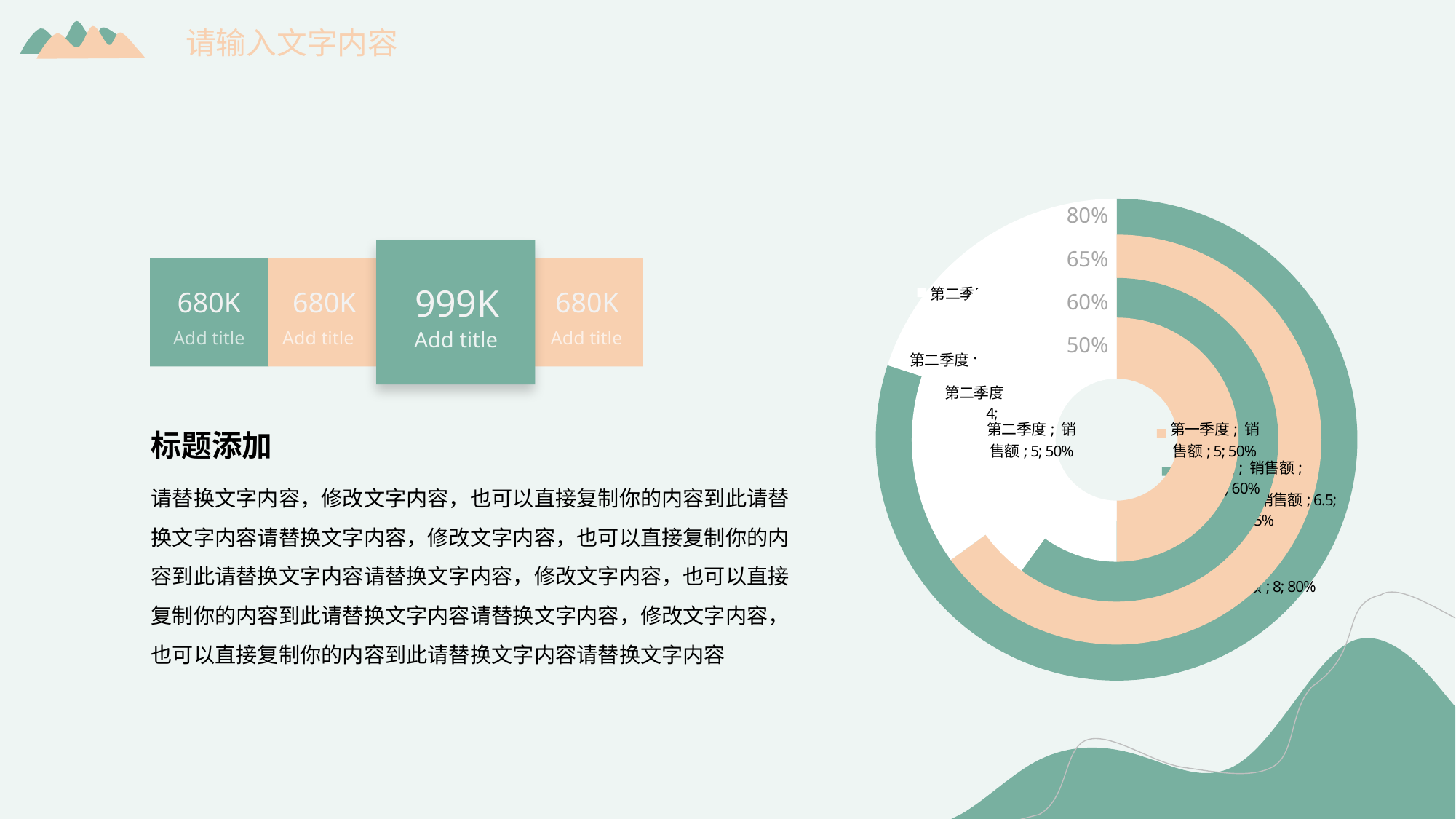
What percentage is printed in the data label for 第二季度 销售额 on the doughnut chart? 50% What value is printed in the data label for 第一季度 销售额 on the doughnut chart? 5 What percentage is printed in the data label for 第一季度 销售额 on the doughnut chart? 50% What two colours are used for the rings of the doughnut chart? green and orange What is the lowest percentage printed among the ring labels on the left side of the doughnut chart? 50% What is the highest percentage printed among the ring labels on the left side of the doughnut chart? 80% What kind of chart is shown on the right side of the slide? doughnut chart What value is printed in the data label for 第二季度 销售额 on the doughnut chart? 5